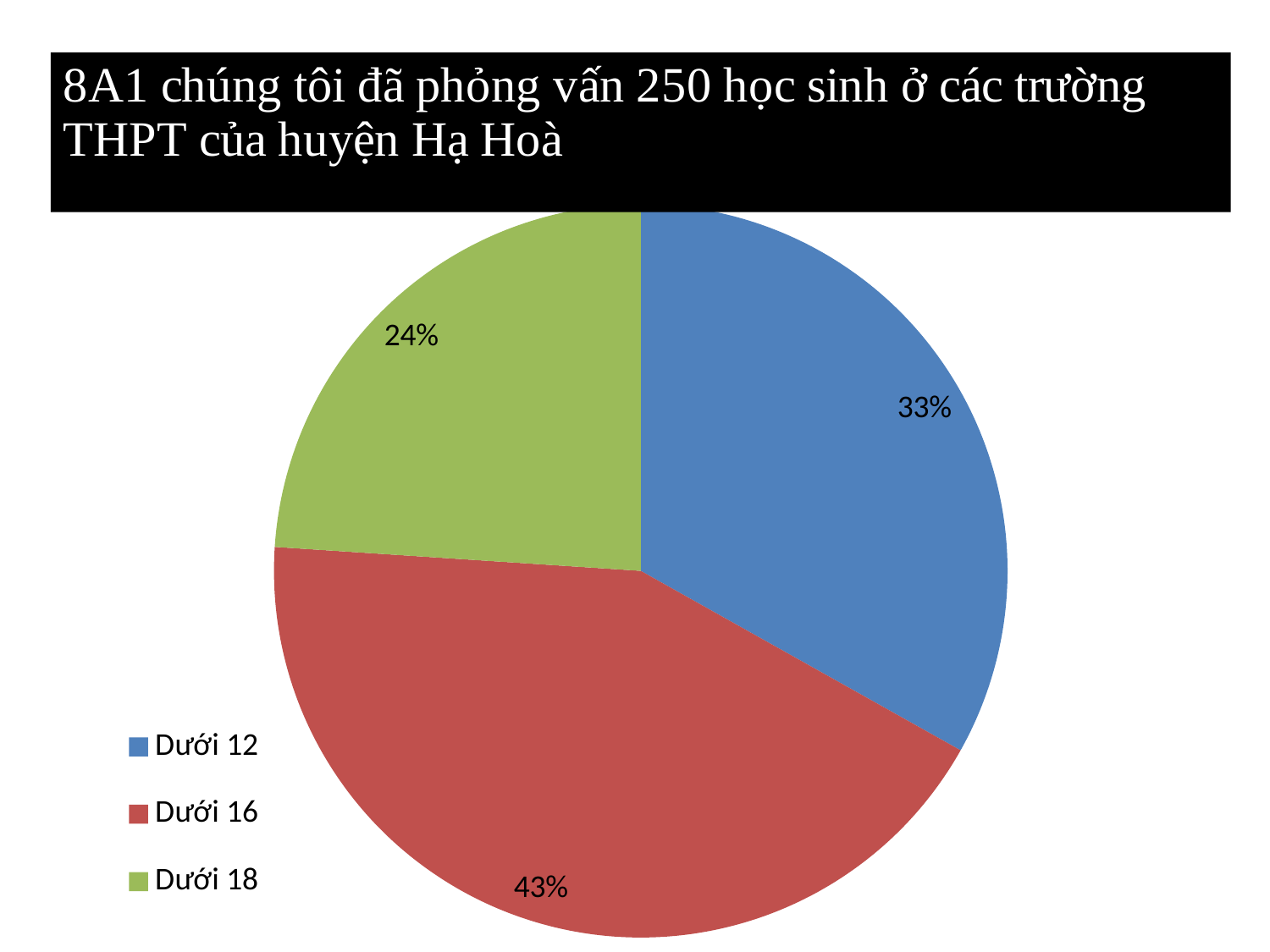
What colour is the slice for "Dưới 16"? red Which category has the smallest slice of the pie? Dưới 18 What share of the pie does "Dưới 18" have? 24% What is the difference in percentage points between "Dưới 12" and "Dưới 18"? 9% Which category is shown in green in the legend? Dưới 18 What is the difference in percentage points between "Dưới 16" and "Dưới 12"? 10% What share of the pie does "Dưới 12" have? 33% Which category has the largest slice of the pie? Dưới 16 What share of the pie does "Dưới 16" have? 43% How many categories does the pie chart have? 3 What kind of chart is shown on the slide? pie chart Which is larger, the slice for "Dưới 12" or the slice for "Dưới 18"? Dưới 12